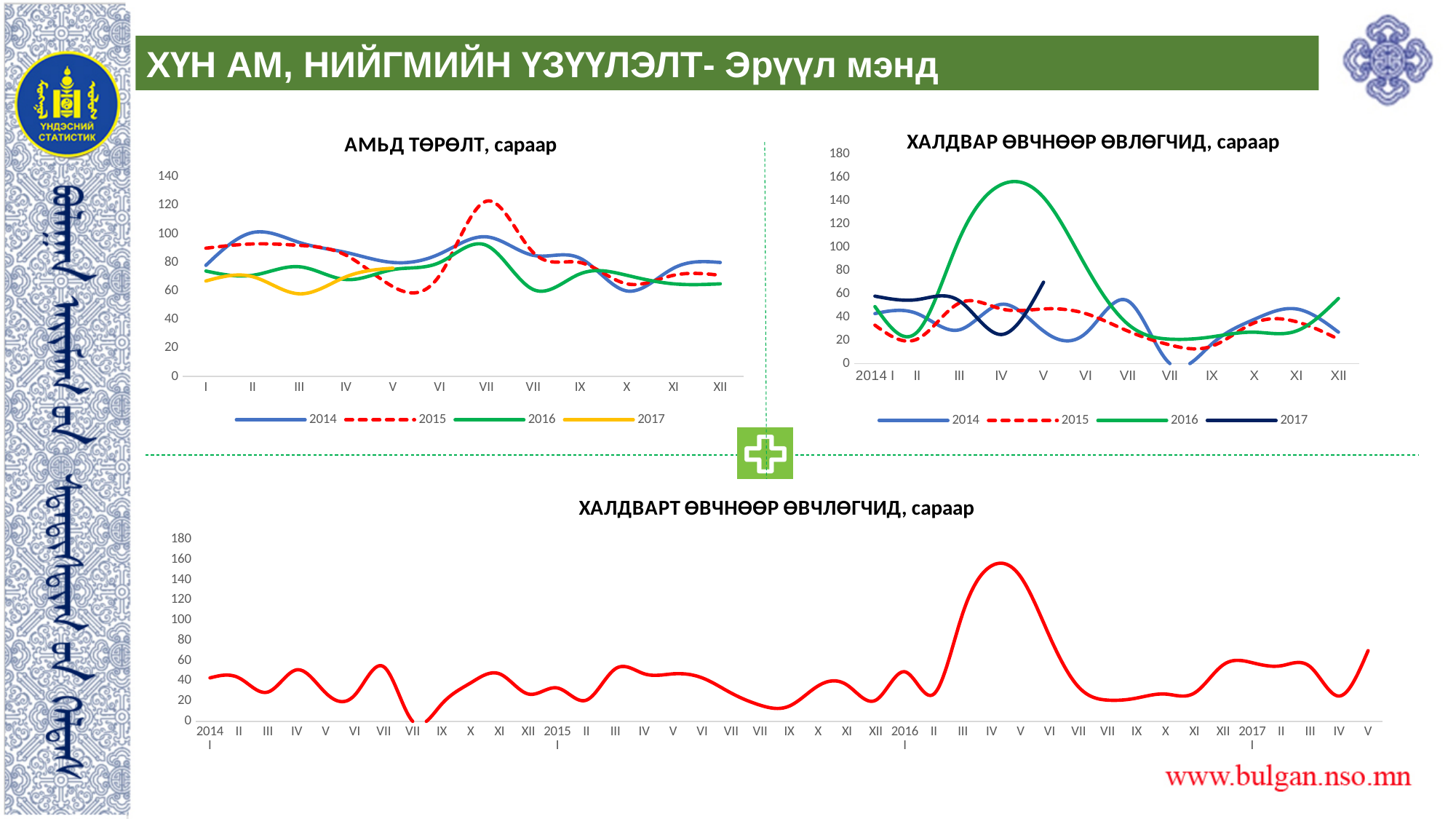
In the chart titled "ХАЛДВАРТ ӨВЧНӨӨР ӨВЧЛӨГЧИД, сараар", is the value at 2016 IV greater or less than 140? greater In the chart titled "ХАЛДВАР ӨВЧНӨӨР ӨВЛӨГЧИД, сараар", is the peak value of the 2016 series greater or less than 140? greater In the chart titled "ХАЛДВАРТ ӨВЧНӨӨР ӨВЧЛӨГЧИД, сараар", does the line rise or fall between 2016 IV and 2016 VII? fall How many series does the legend of the chart titled "ХАЛДВАР ӨВЧНӨӨР ӨВЛӨГЧИД, сараар" list? 4 What kind of chart is the chart titled "АМЬД ТӨРӨЛТ, сараар"? line chart In the chart titled "АМЬД ТӨРӨЛТ, сараар", which series is drawn as a red dashed line? 2015 What kind of chart is the chart titled "ХАЛДВАРТ ӨВЧНӨӨР ӨВЧЛӨГЧИД, сараар"? line chart In the chart titled "АМЬД ТӨРӨЛТ, сараар", is the value of the 2015 series at month VII greater or less than 100? greater How many series does the legend of the chart titled "АМЬД ТӨРӨЛТ, сараар" list? 4 In the chart titled "ХАЛДВАР ӨВЧНӨӨР ӨВЛӨГЧИД, сараар", which series reaches the highest value on the chart? 2016